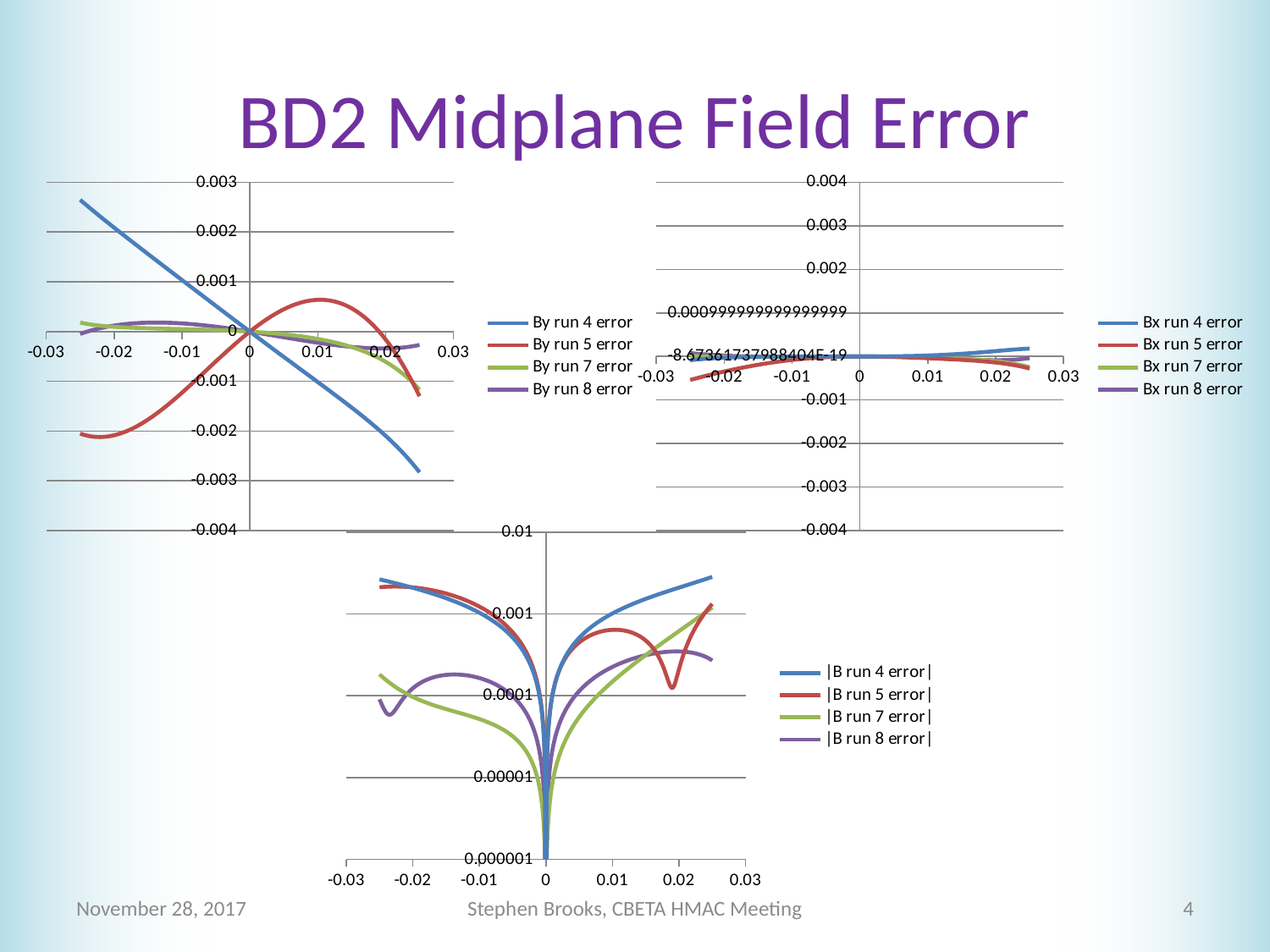
In the top-left chart, which series reaches the highest value? By run 4 error In the bottom chart, how many series does the legend list? 4 How many charts are shown on the slide? 3 In the top-left chart, how many series does the legend list? 4 In the top-right chart, what are the legend entries? Bx run 4 error, Bx run 5 error, Bx run 7 error, Bx run 8 error What is the title of the slide containing the charts? BD2 Midplane Field Error In the bottom chart, at x = 0.02, which is larger: |B run 4 error| or |B run 7 error|? |B run 4 error| In the top-left chart, is the value of By run 4 error at x = 0.02 greater or less than -0.001? less What kind of chart is the top-left chart on the slide? line chart In the top-left chart, is the value of By run 4 error at x = -0.02 greater or less than 0.001? greater In the bottom chart, is the value of |B run 4 error| at x = 0.025 greater or less than 0.001? greater In the top-left chart, does the By run 4 error line rise or fall as x increases from -0.03 to 0.03? fall